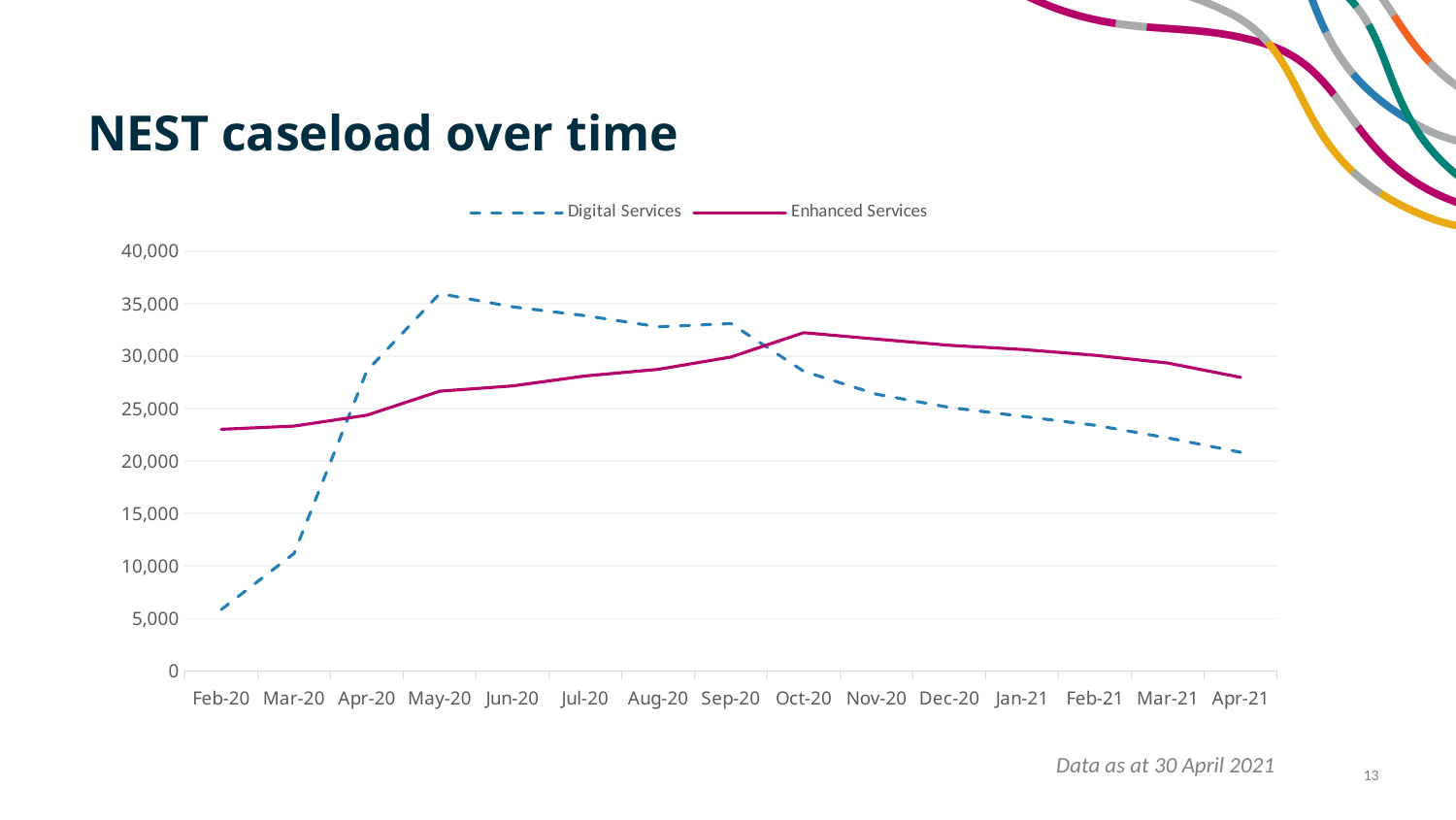
How many series does the legend list? 2 In which month is the Digital Services value lowest? Feb-20 What is the title of the chart? NEST caseload over time Does the Digital Services line rise or fall from May-20 to Apr-21? fall How many months are shown on the x axis? 15 In which month does the Enhanced Services line reach its highest value? Oct-20 Is the value for Enhanced Services in Feb-20 greater or less than 25,000? less What kind of chart is shown on the slide? line chart Is the value for Digital Services in May-20 greater or less than 30,000? greater Is the value for Digital Services in Apr-21 greater or less than 25,000? less Which series has the higher value in Jan-21, Digital Services or Enhanced Services? Enhanced Services In which month does the Digital Services line reach its highest value? May-20